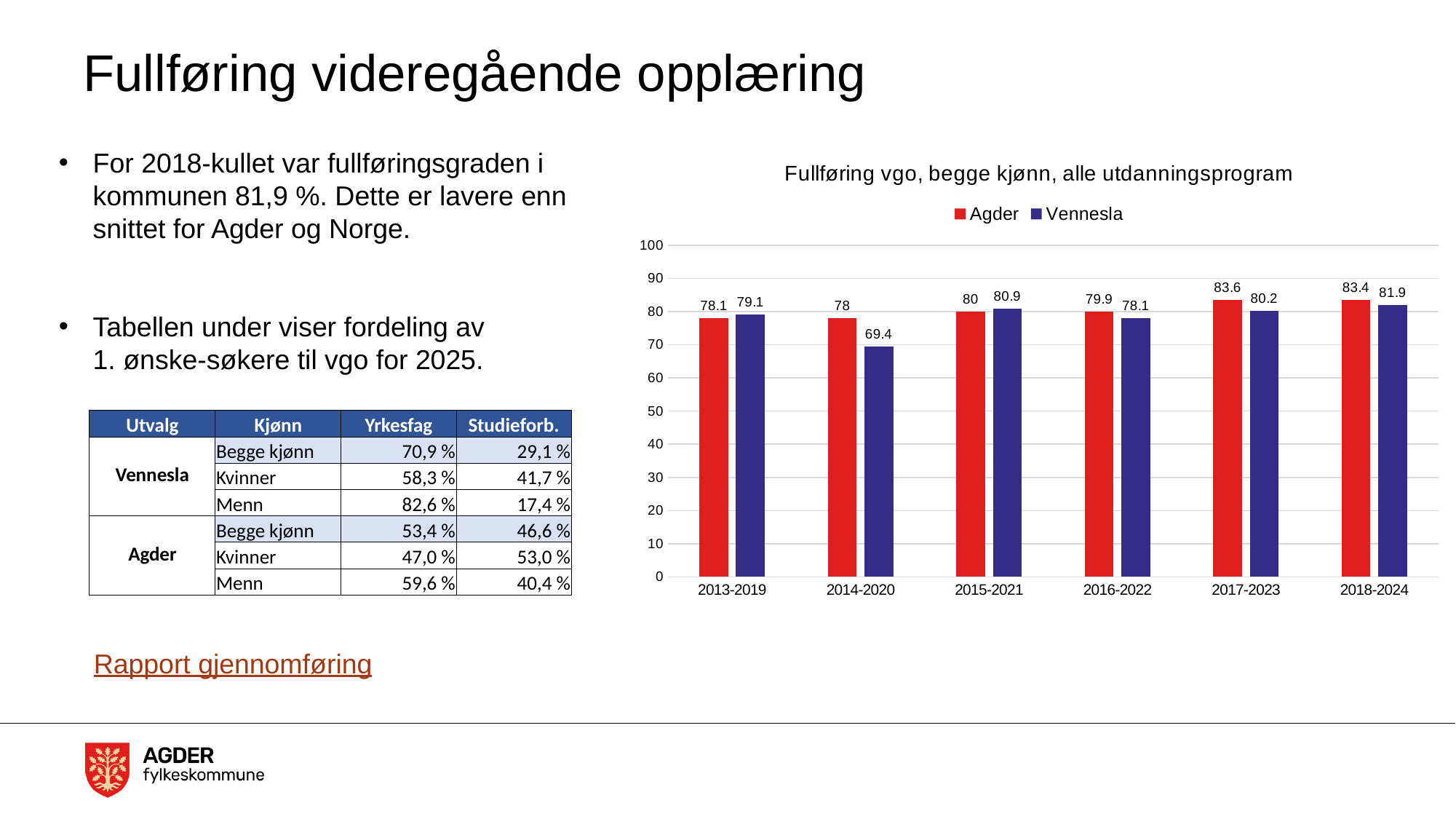
What is the value for Agder in 2017-2023? 83.6 How many series does the legend list? 2 Which period has the highest value for Agder? 2017-2023 What is the title of the chart? Fullføring vgo, begge kjønn, alle utdanningsprogram Is the value for Vennesla in 2014-2020 greater or less than 70? less What is the difference between Agder and Vennesla in 2014-2020? 8.6 What is the value for Vennesla in 2014-2020? 69.4 Which is larger in 2015-2021, Agder or Vennesla? Vennesla How many periods are shown on the x axis? 6 What kind of chart is shown? bar chart Which period has the lowest value for Vennesla? 2014-2020 What is the value for Vennesla in 2018-2024? 81.9